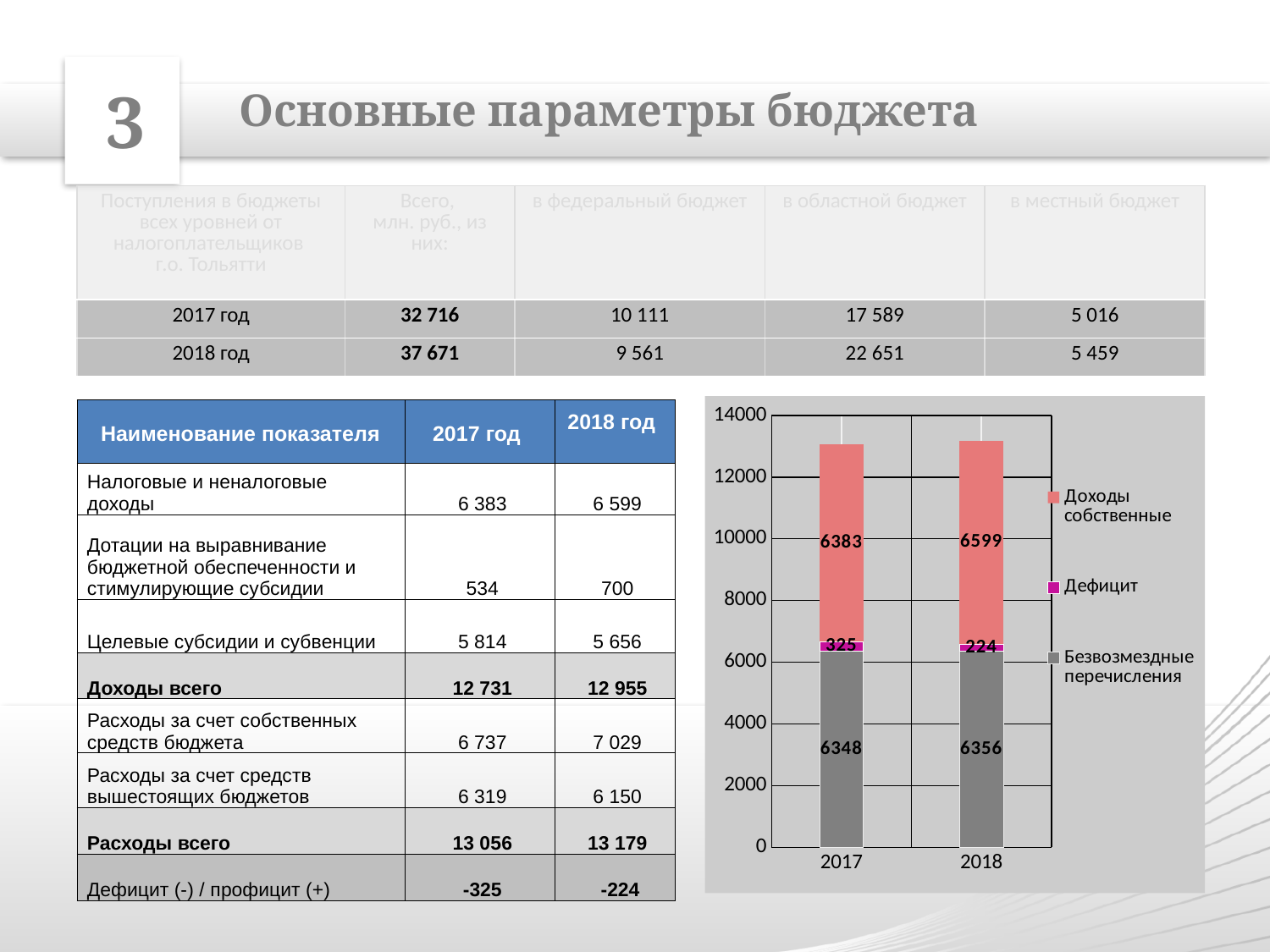
Which series is shown in red in the chart? Доходы собственные What is the total of the stacked bar for 2018? 13179 Which year has the larger Дефицит value in the chart, 2017 or 2018? 2017 What is the total of the stacked bar for 2017? 13056 How many series does the chart legend list? 3 What is the value of Безвозмездные перечисления for 2018 in the chart? 6356 What is the value of Доходы собственные for 2018 in the chart? 6599 What is the value of Дефицит for 2017 in the chart? 325 What kind of chart is shown on the slide? stacked bar chart How many categories are shown on the x axis of the chart? 2 By how much does Доходы собственные in 2018 exceed Доходы собственные in 2017? 216 What is the value of Доходы собственные for 2017 in the chart? 6383